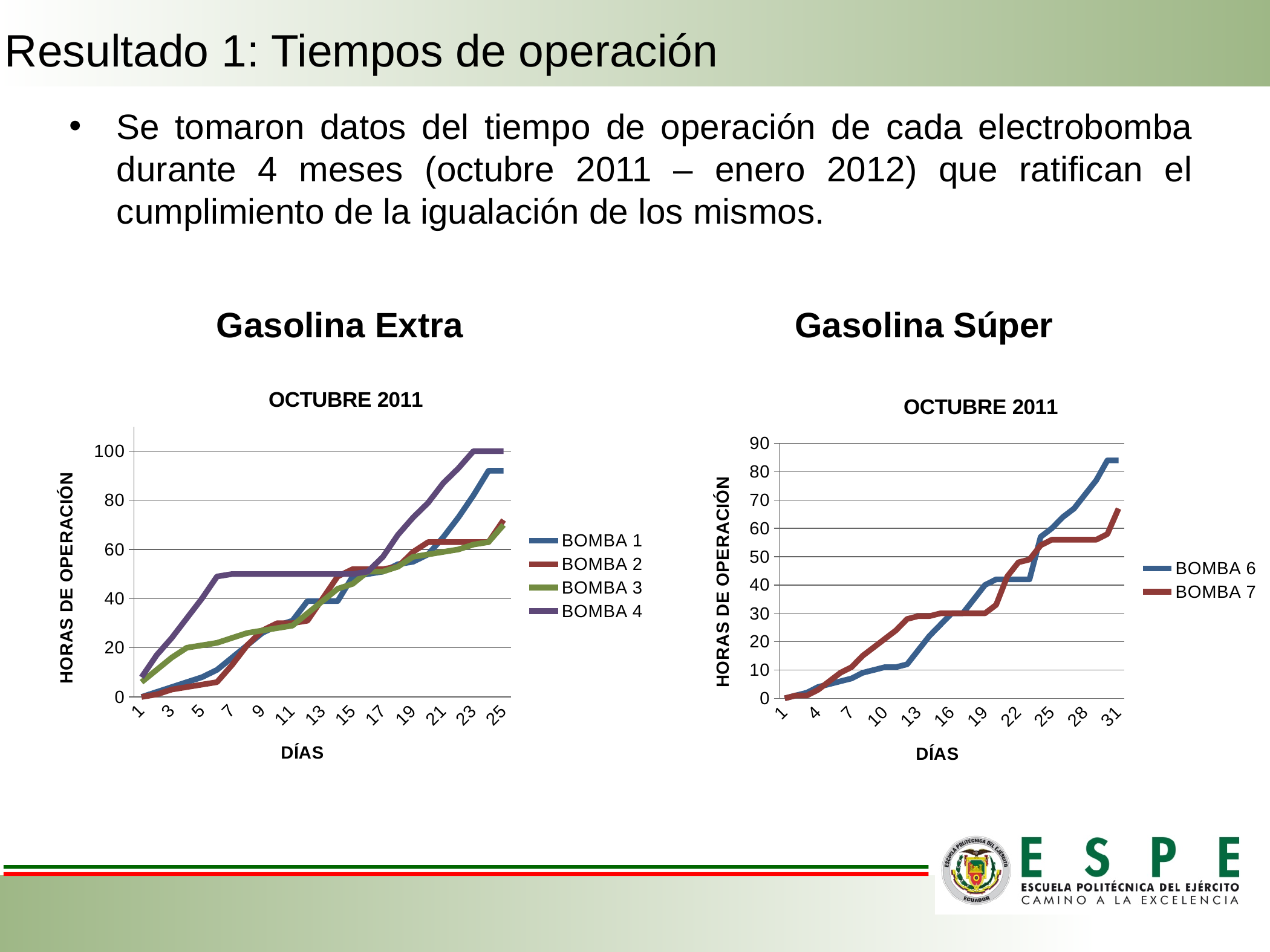
In the Gasolina Extra chart, which series has the highest value on day 25? BOMBA 4 What is the y-axis label of the Gasolina Súper chart? HORAS DE OPERACIÓN Which series are listed in the legend of the Gasolina Súper chart? BOMBA 6, BOMBA 7 In the Gasolina Súper chart, is the value for BOMBA 7 on day 31 greater or less than 70? less In the Gasolina Extra chart, is the value for BOMBA 4 on day 25 greater or less than 80? greater What kind of chart is the Gasolina Extra chart on the left? line chart In the Gasolina Extra chart, is the value for BOMBA 2 on day 25 greater or less than 80? less How many series does the legend of the Gasolina Súper chart list? 2 In the Gasolina Súper chart, do the values for BOMBA 6 rise or fall along the x axis? rise In the Gasolina Extra chart, which is larger on day 25, BOMBA 1 or BOMBA 3? BOMBA 1 How many series does the legend of the Gasolina Extra chart list? 4